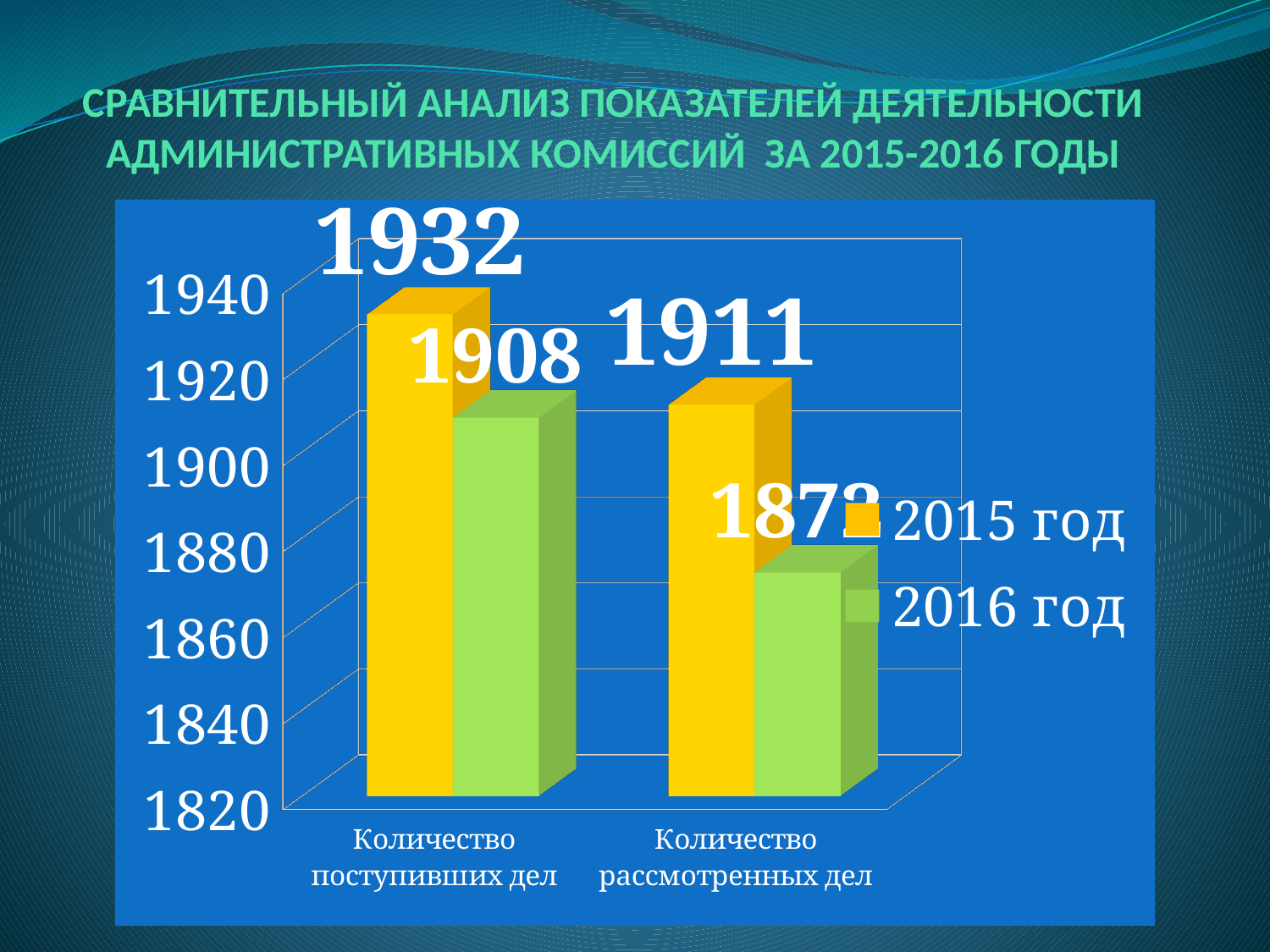
What is the value for 2016 год for Количество поступивших дел? 1908 What is the value for 2015 год for Количество поступивших дел? 1932 Is the value for 2016 год for Количество рассмотренных дел greater or less than 1880? less Which is larger: the 2016 год value for Количество поступивших дел or the 2015 год value for Количество рассмотренных дел? 2015 год value for Количество рассмотренных дел What is the difference between the 2015 год values for Количество поступивших дел and Количество рассмотренных дел? 21 What is the value for 2015 год for Количество рассмотренных дел? 1911 Which category has the highest value for 2015 год? Количество поступивших дел Which series has the lowest value for Количество рассмотренных дел? 2016 год What is the difference between the 2015 год and 2016 год values for Количество поступивших дел? 24 How many series does the legend list? 2 What kind of chart is shown on the slide? bar chart How many categories are shown on the x axis? 2